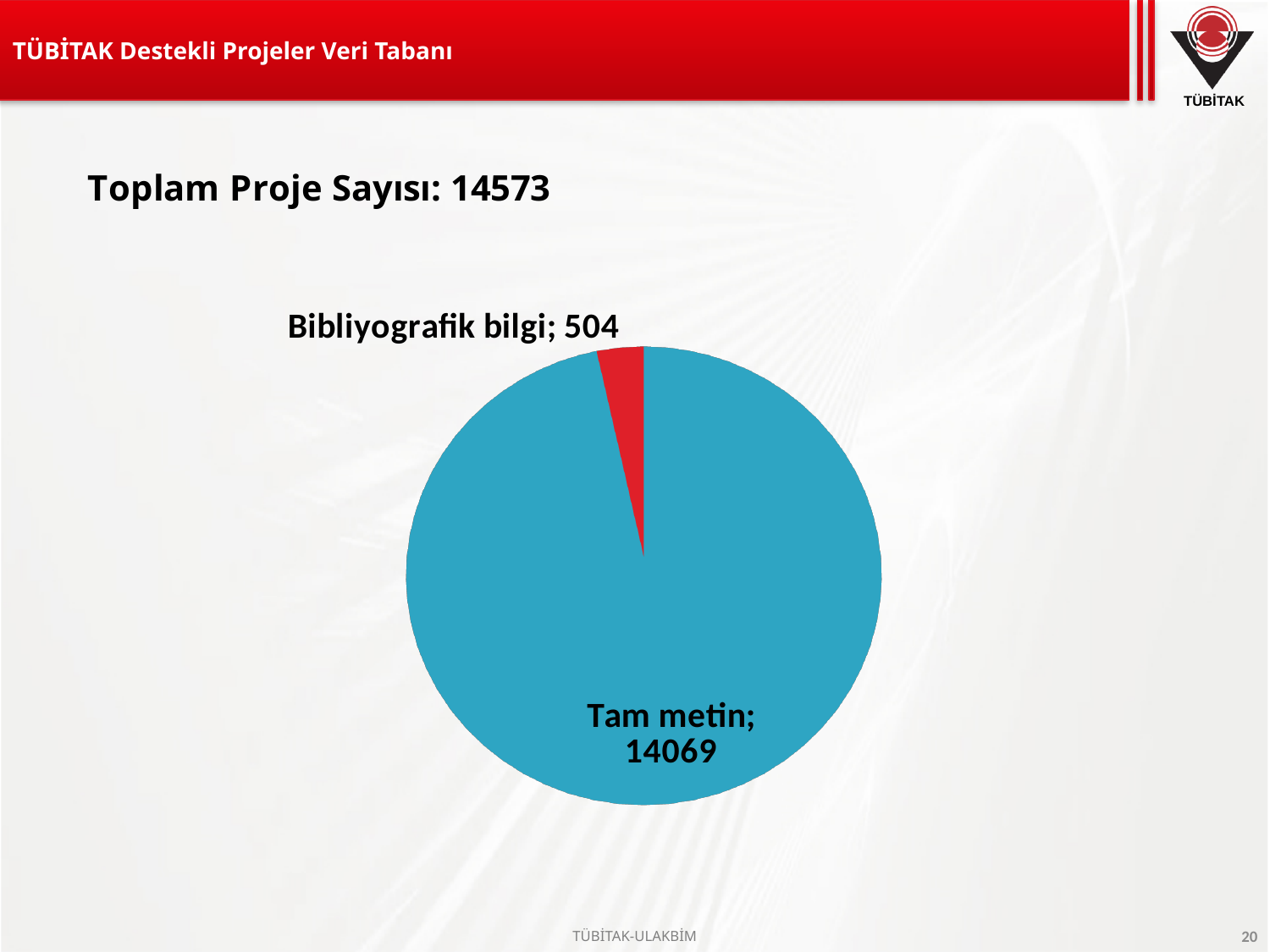
What is the value for Tam metin in the pie chart? 14069 Which slice of the pie chart is the smallest? Bibliyografik bilgi What is the difference between the Tam metin and Bibliyografik bilgi values? 13565 What colour is the Bibliyografik bilgi slice? red Which slice of the pie chart is the largest? Tam metin What is the total of the two slices in the pie chart? 14573 How many slices does the pie chart have? 2 What kind of chart is shown on the slide? pie chart What total project count (Toplam Proje Sayısı) is stated on the slide? 14573 What is the value for Bibliyografik bilgi in the pie chart? 504 Which is larger, Tam metin or Bibliyografik bilgi? Tam metin